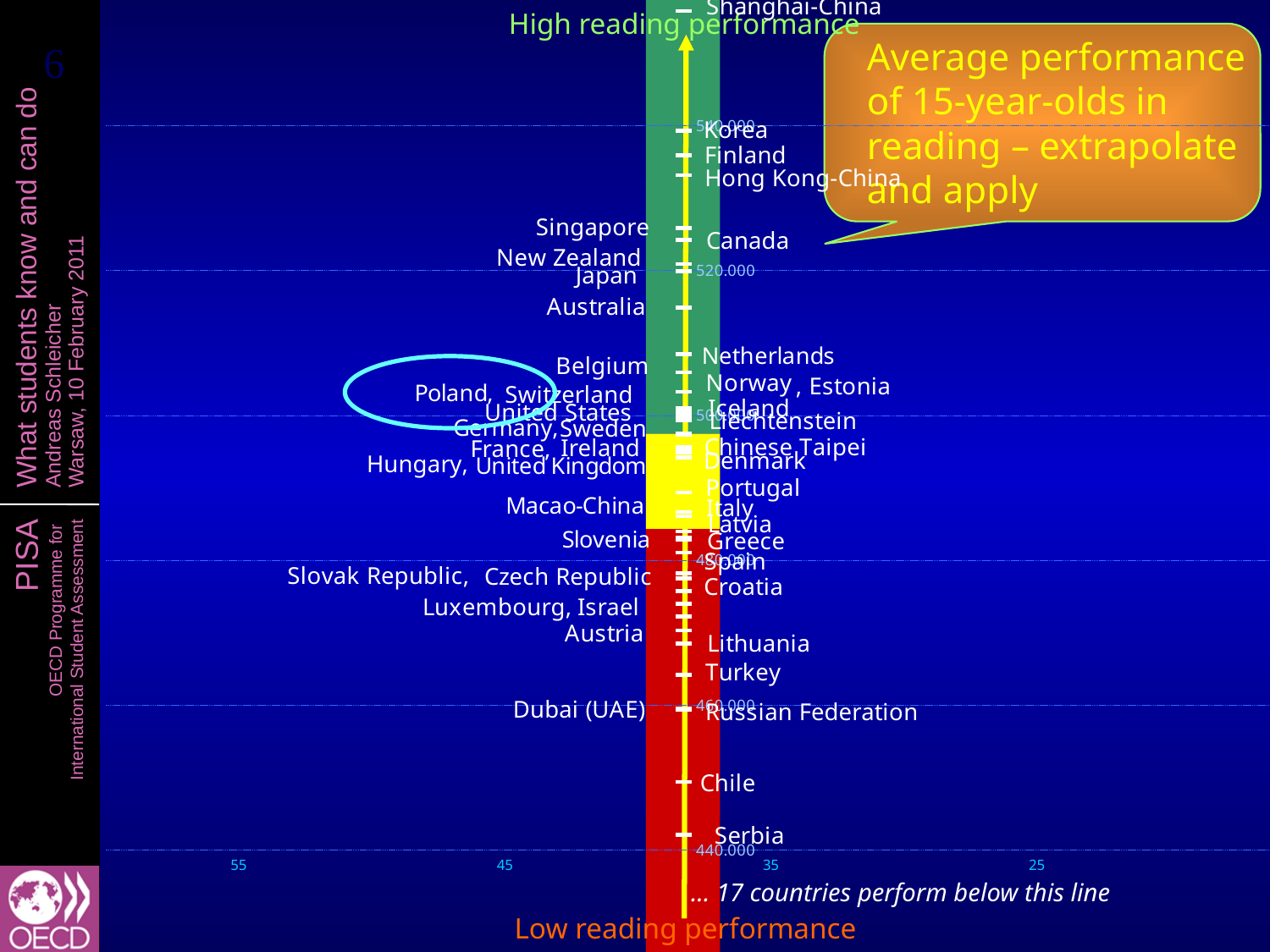
Which country is placed highest on the reading performance scale? Shanghai-China Is the value for Lithuania greater or less than 460? greater Is the value for Australia greater or less than 520? less Is the value for Serbia greater or less than 460? less Which has the lower reading performance, Canada or Chile? Chile Which has the higher reading performance, Finland or Turkey? Finland According to the note at the bottom of the chart, how many countries perform below the line? 17 What does the callout box on the chart say? Average performance of 15-year-olds in reading – extrapolate and apply Which labelled country is placed lowest on the reading performance scale? Serbia